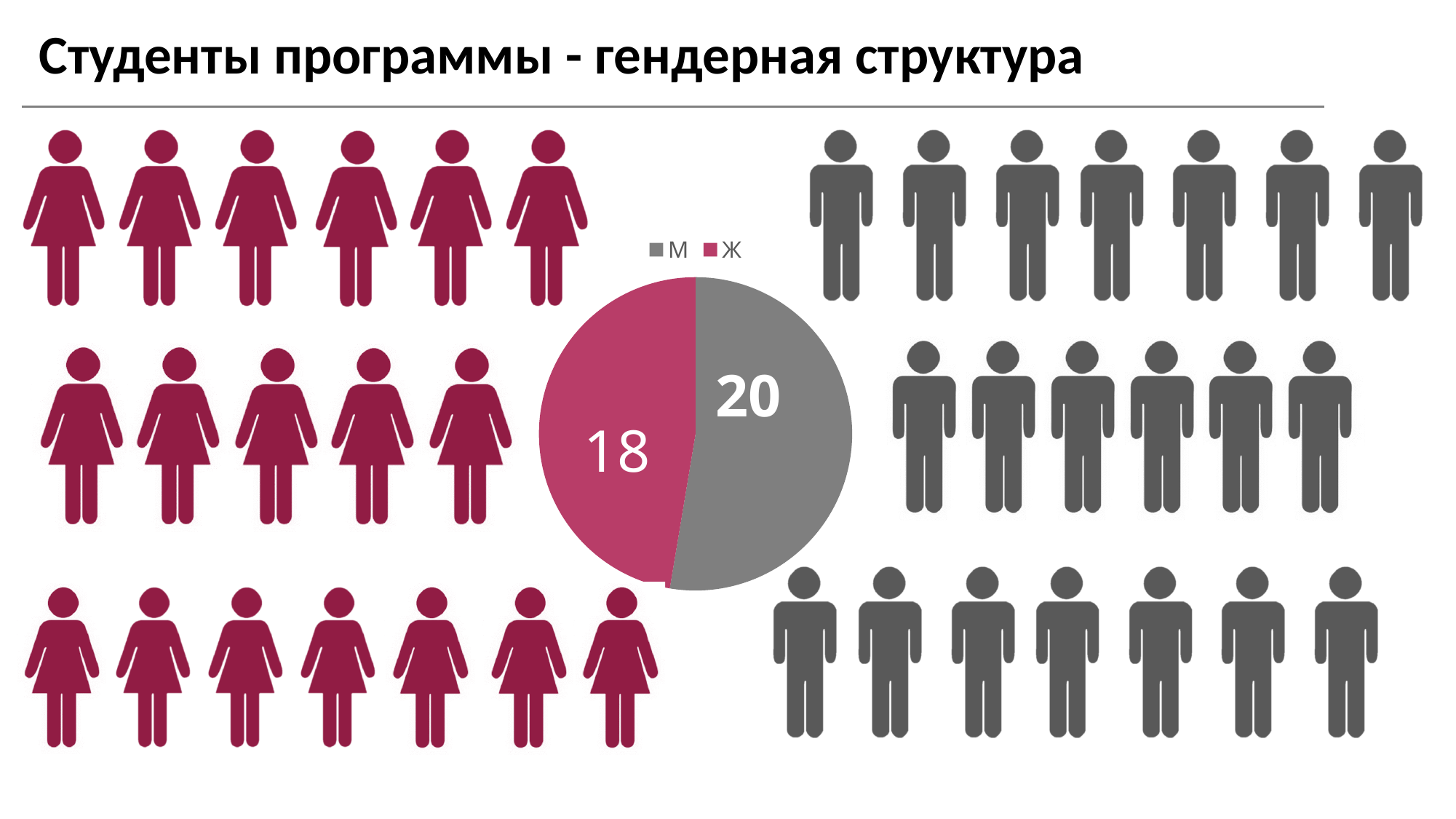
What is the total of the two values shown in the pie chart? 38 What colour is the Ж slice in the pie chart? pink (magenta) Which category has the larger slice in the pie chart? М Which is larger, the value for Ж or the value for М? М What is the value for Ж in the pie chart? 18 Which category has the smaller slice in the pie chart? Ж What kind of chart is shown on the slide? pie chart What is the value for М in the pie chart? 20 What entries does the legend of the pie chart list? М, Ж How many slices does the pie chart have? 2 What is the difference between the values for М and Ж? 2